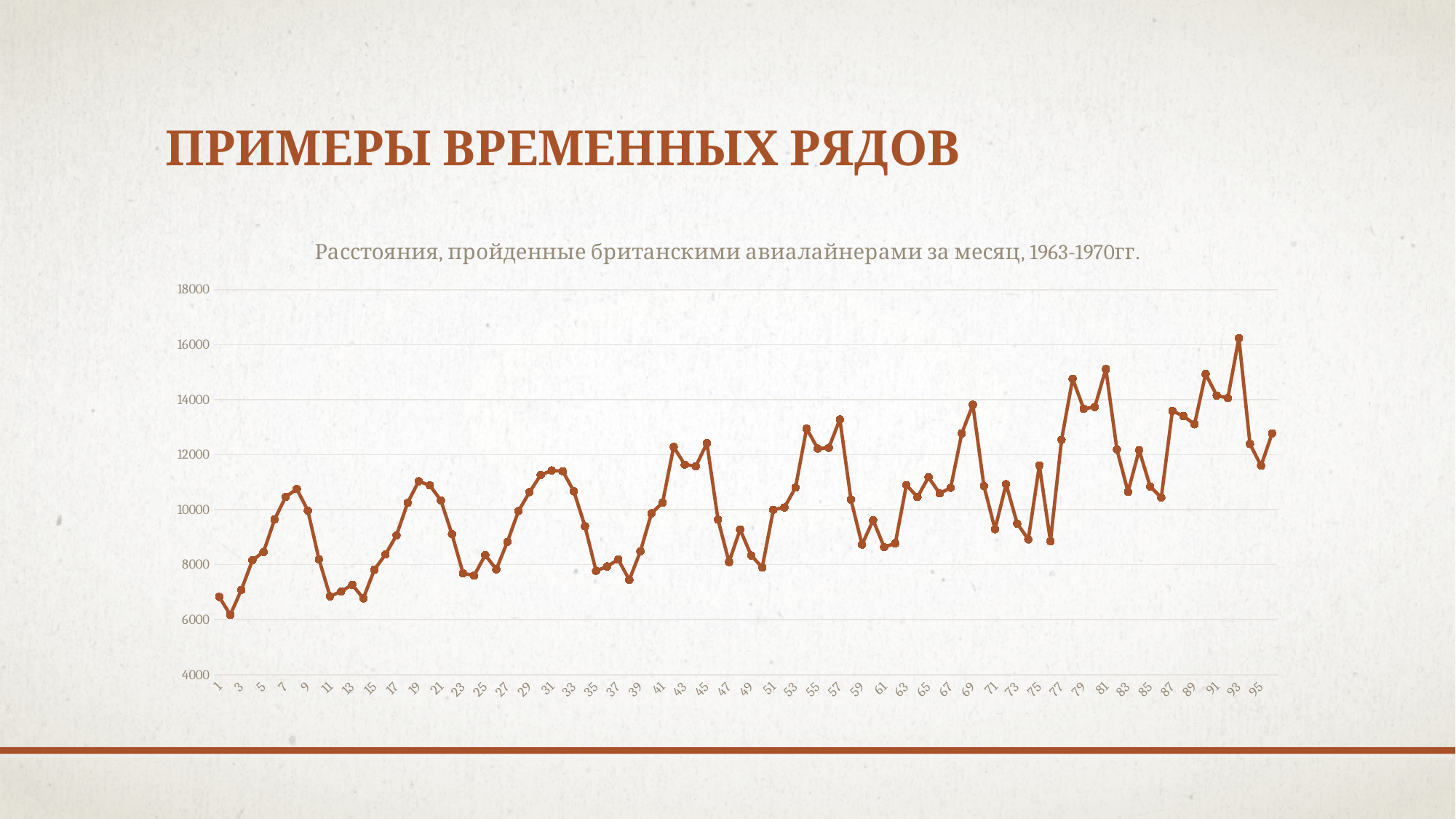
Is the value at point 1 greater or less than 8000? less Is the value at point 69 greater or less than 12000? greater What is the highest value shown on the vertical axis? 18000 Is the value at point 49 greater or less than 10000? less What kind of chart is shown on the slide? line chart Which is larger, the value at point 93 or the value at point 1? point 93 At which x-axis point does the line reach its highest value? 93 Which is larger, the value at point 81 or the value at point 49? point 81 What is the title of the chart? Расстояния, пройденные британскими авиалайнерами за месяц, 1963-1970гг. Overall, do the values rise or fall along the x axis from point 1 to point 95? rise At which x-axis point does the line reach its lowest value? 2